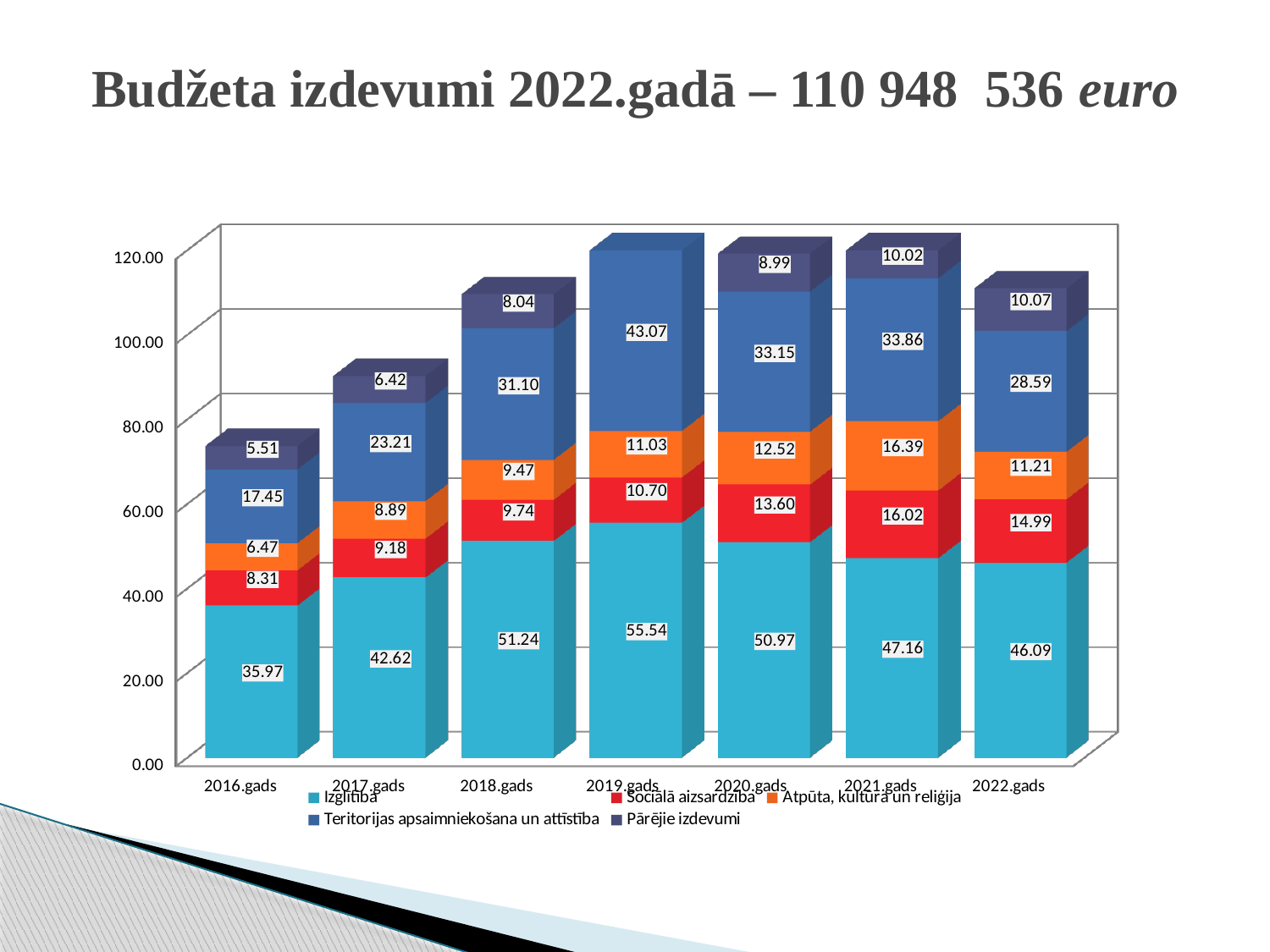
How many years are shown on the x axis? 7 What is the value of Izglītība for 2022.gads? 46.09 What kind of chart is shown on the slide? Stacked bar chart What is the total of the stacked bar for 2022.gads? 110.95 What is the difference between the Sociālā aizsardzība value for 2021.gads and for 2016.gads? 7.71 In which year is the Pārējie izdevumi segment the lowest? 2016.gads Which year has the larger Atpūta, kultūra un reliģija value, 2020.gads or 2021.gads? 2021.gads In which year is the Izglītība segment the highest? 2019.gads Does the Izglītība value rise or fall from 2019.gads to 2022.gads? Fall What is the value of Teritorijas apsaimniekošana un attīstība for 2019.gads? 43.07 How many series does the legend list? 5 What is the total of the stacked bar for 2016.gads? 73.71